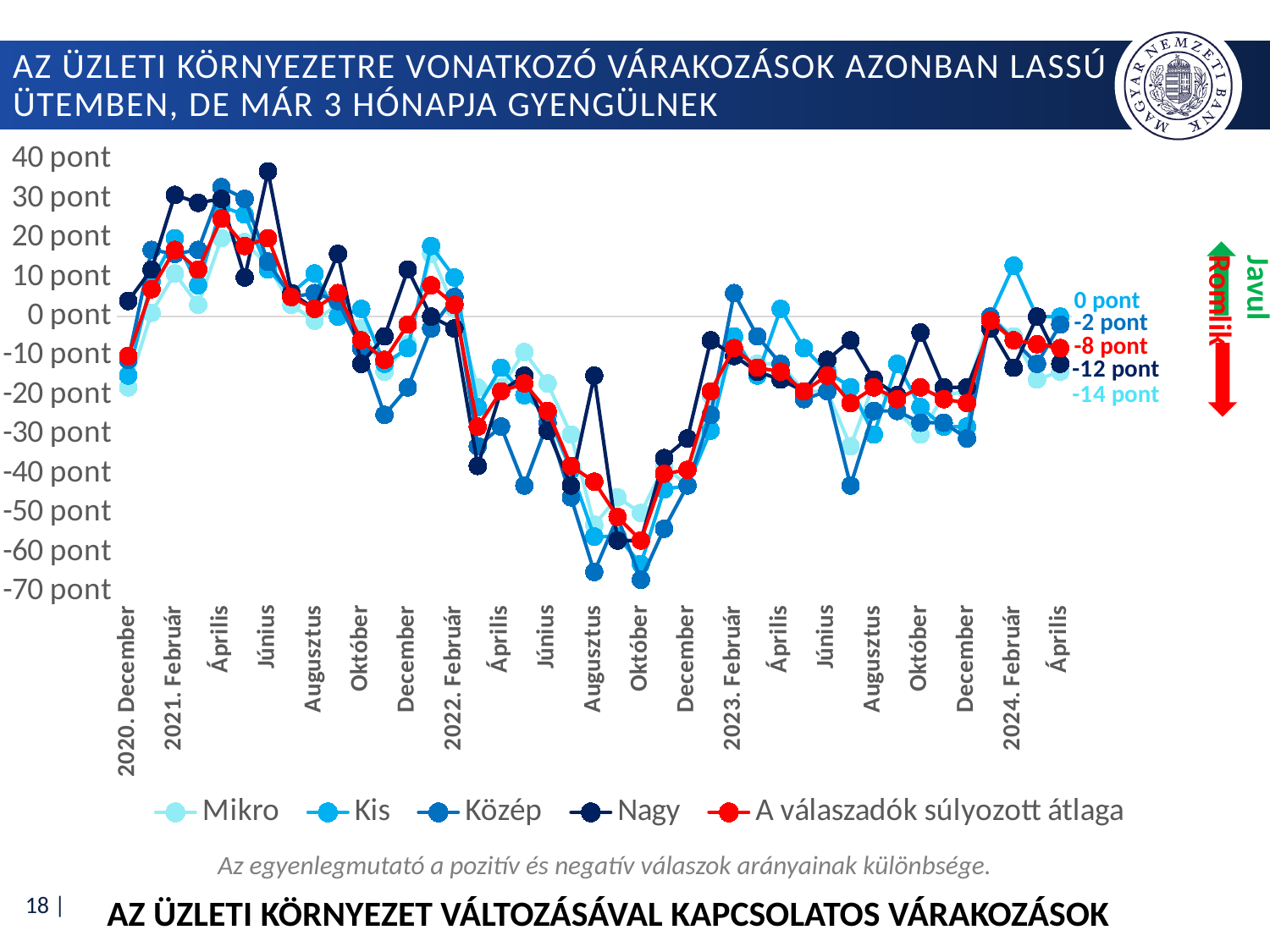
At the last data point (2024 April), which is higher: Közép or Nagy? Közép What kind of chart is shown on the slide? line chart Which series has the lowest value at the last data point (2024 April)? Mikro What is the value of the Kis series at the last data point (2024 April)? 0 pont How many series does the legend list? 5 What is the value of the Mikro series at the last data point (2024 April)? -14 pont What is the value of 'A válaszadók súlyozott átlaga' at the last data point (2024 April)? -8 pont What is the difference between the Kis and Mikro values at the last data point (2024 April)? 14 pont Is the value of 'A válaszadók súlyozott átlaga' in 2022 October greater or less than -50 pont? less What is the value of the Nagy series at the last data point (2024 April)? -12 pont Does 'A válaszadók súlyozott átlaga' rise or fall between 2022 February and 2022 October? fall Which series has the highest value at the last data point (2024 April)? Kis